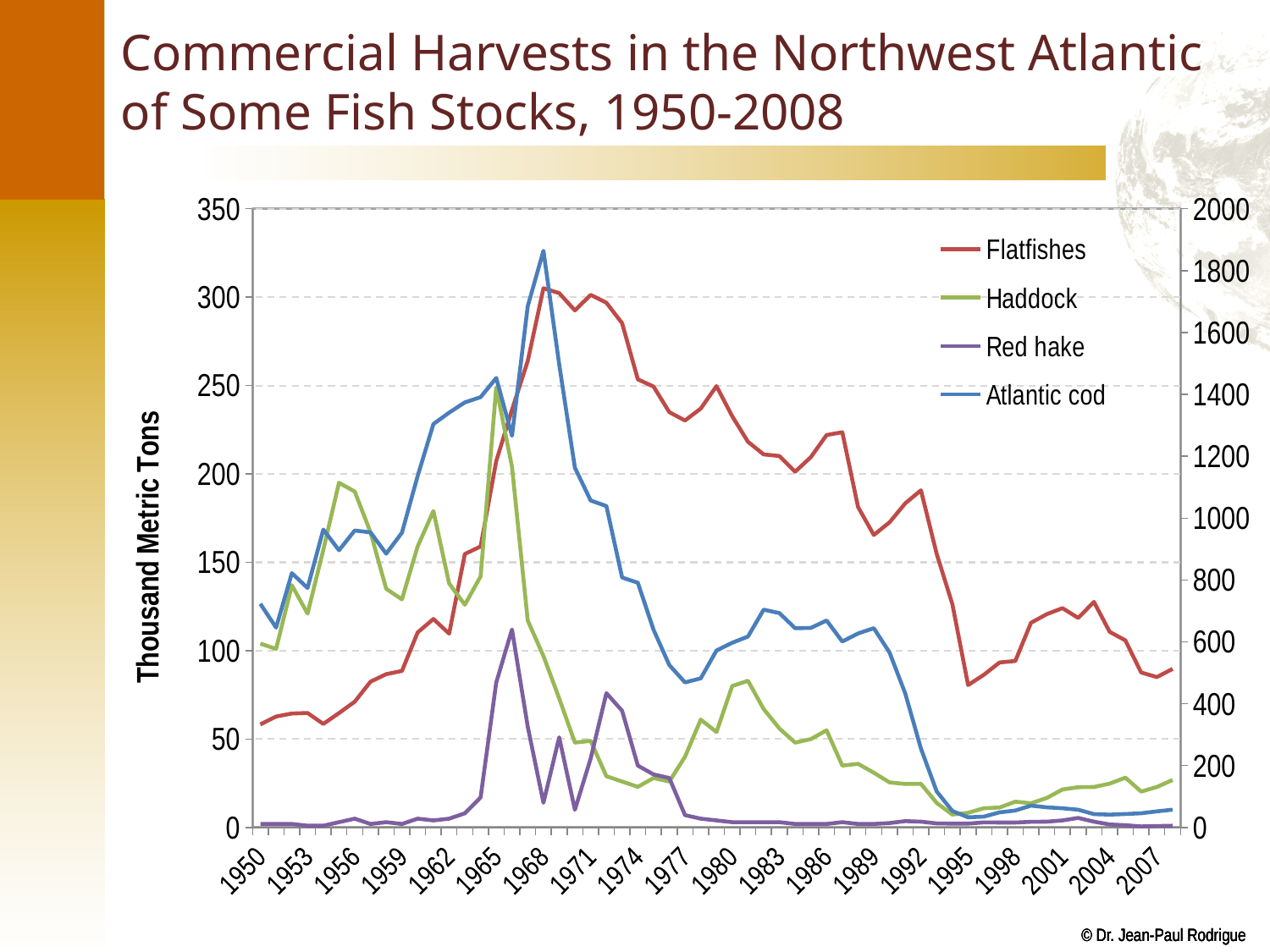
How many series does the legend list? 4 Read against the left axis, is the Haddock value in 1965 greater or less than 200? greater Read against the left axis, is the Red hake value in 1980 greater or less than 50? less Which series reaches the highest point on the chart? Atlantic cod What is the label on the left vertical axis? Thousand Metric Tons What is the title of the chart? Commercial Harvests in the Northwest Atlantic of Some Fish Stocks, 1950-2008 In 1968, which line is higher, Flatfishes or Haddock? Flatfishes In 1995, which line is higher, Flatfishes or Haddock? Flatfishes What kind of chart is shown on the slide? line chart Read against the left axis, is the Flatfishes value in 1950 greater or less than 100? less Does the Flatfishes line rise or fall between 1950 and 1968? rise Does the Atlantic cod line rise or fall between 1968 and 1977? fall